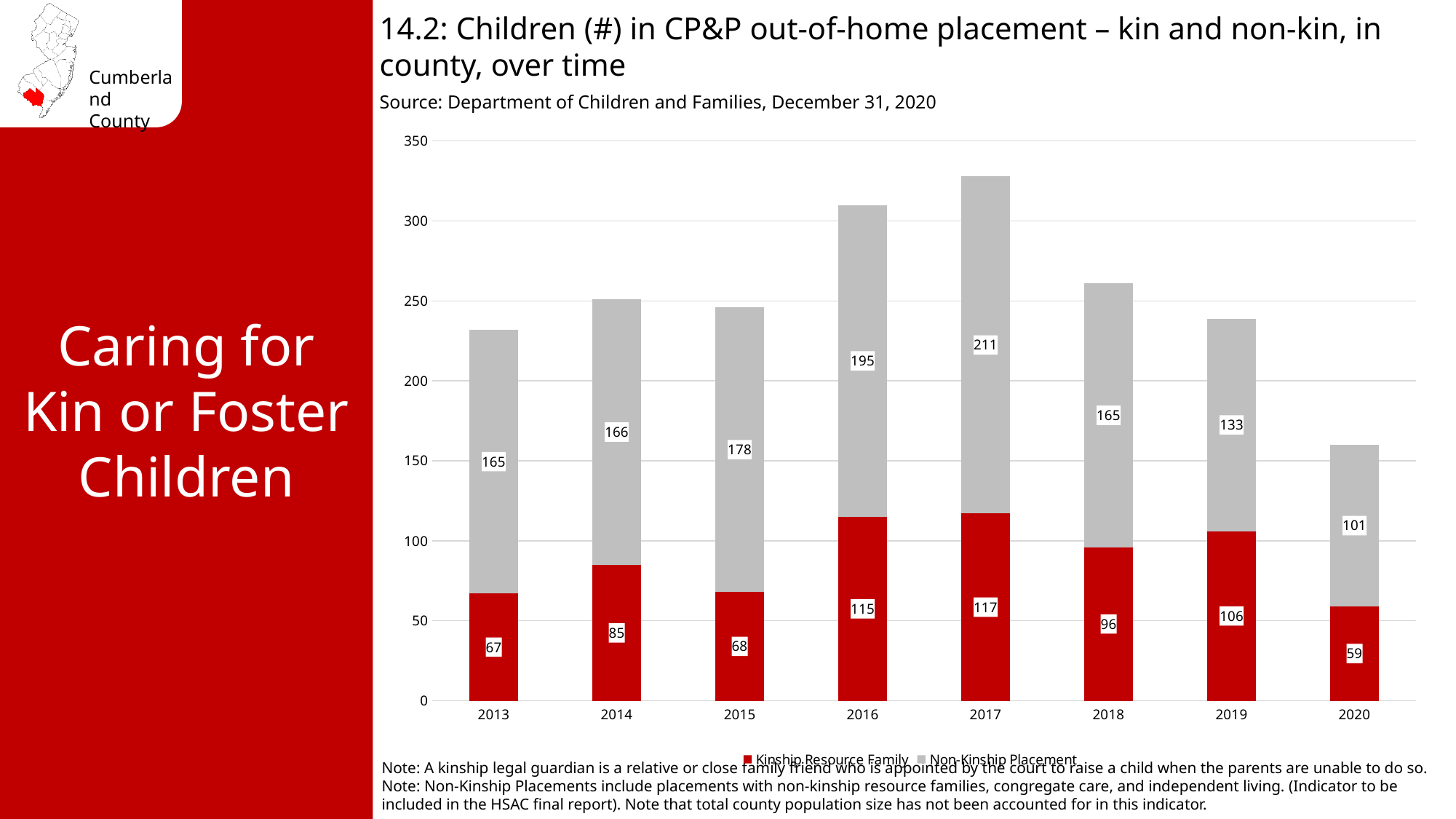
What kind of chart is shown on the slide? Stacked bar chart How many series does the legend list? 2 What is the difference between the Non-Kinship Placement values for 2017 and 2018? 46 What is the total of the stacked bar for 2017? 328 How many years are shown on the x axis? 8 Which colour represents Kinship Resource Family in the chart? Red Which year has the lowest Kinship Resource Family value? 2020 Which year has the highest Non-Kinship Placement value? 2017 What is the Non-Kinship Placement value for 2019? 133 What is the Kinship Resource Family value for 2016? 115 What is the total of the stacked bar for 2020? 160 Which is larger, the Kinship Resource Family value for 2014 or for 2015? 2014